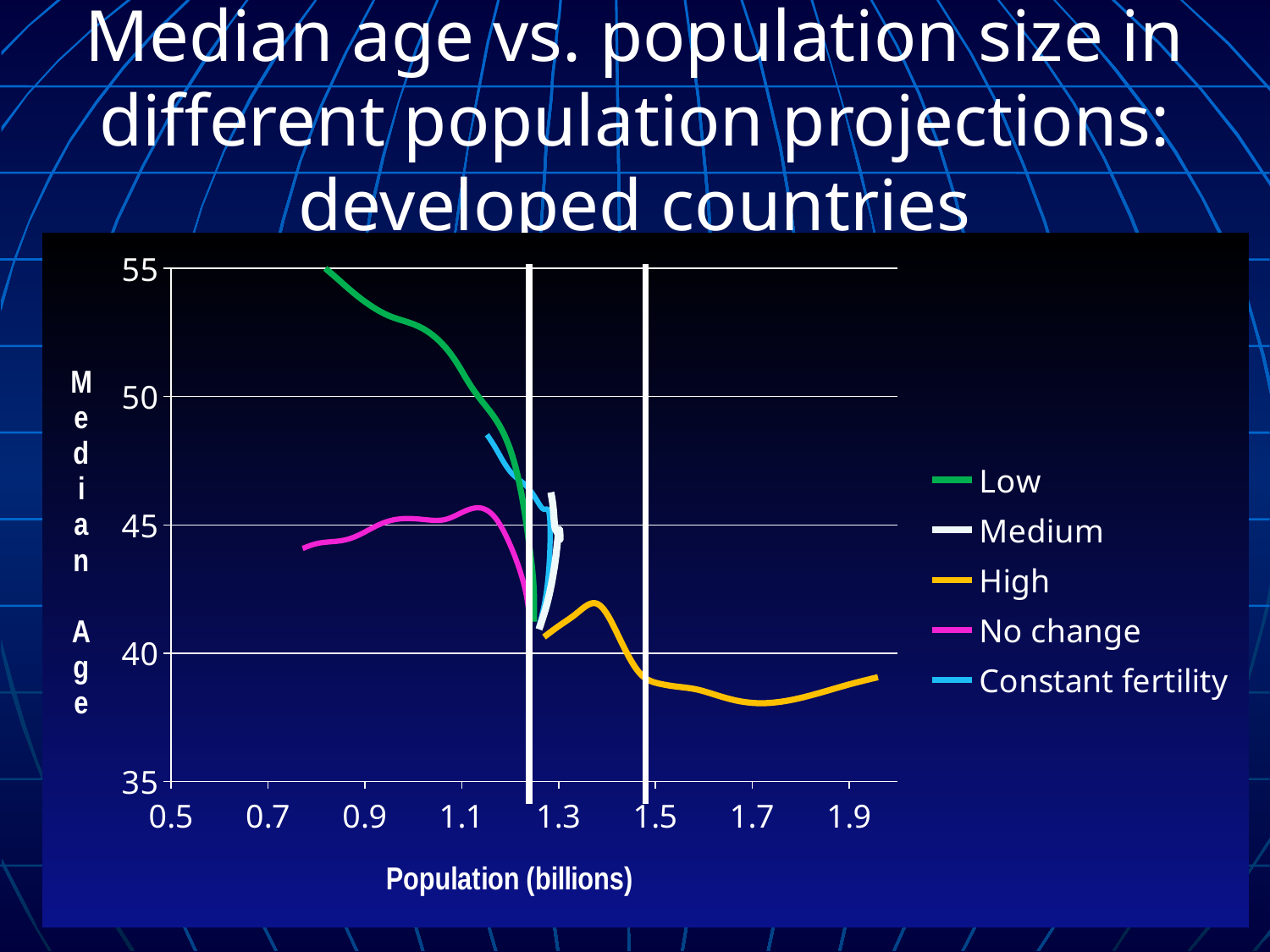
Does the median age for the Low series rise or fall as population increases? fall What is the title of the horizontal axis? Population (billions) Which series reaches the lowest median age on the chart? High Which series reaches the highest median age on the chart? Low How many series does the legend list? 5 Is the median age at the left-hand start of the Constant fertility series greater or less than 45? greater Which series extends to the largest population value on the x axis? High Is the median age at the left-hand start of the No change series greater or less than 45? less Which series starts at a higher median age, Low or No change? Low Which series is drawn in green according to the legend? Low Is the median age at the right-hand end of the High series greater or less than 40? less What kind of chart is shown on the slide? Line chart